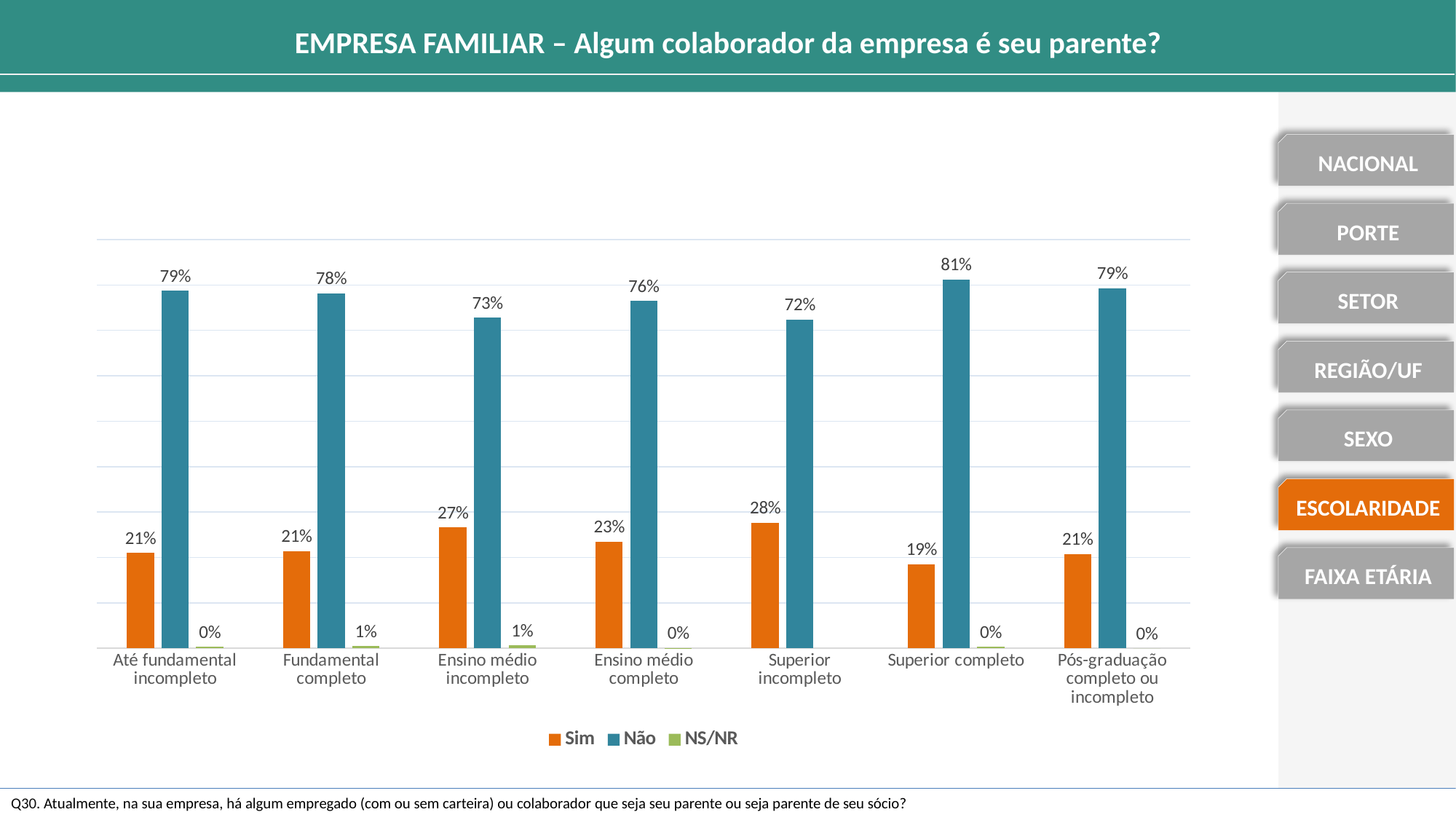
What is the value of "NS/NR" for "Fundamental completo"? 1% Which colour represents the "Sim" series in the legend? Orange What is the value of "Sim" for "Superior incompleto"? 28% What is the value of "Não" for "Superior completo"? 81% What kind of chart is shown on the slide? Bar chart Which is larger: the "Sim" value for "Ensino médio incompleto" or for "Ensino médio completo"? Ensino médio incompleto Which category has the lowest "Não" value? Superior incompleto Which category has the highest "Sim" value? Superior incompleto What is the difference between the "Não" and "Sim" values for "Até fundamental incompleto"? 58% What is the difference between the "Não" values for "Superior completo" and "Superior incompleto"? 9% How many education categories are shown on the x axis? 7 How many series does the legend list? 3